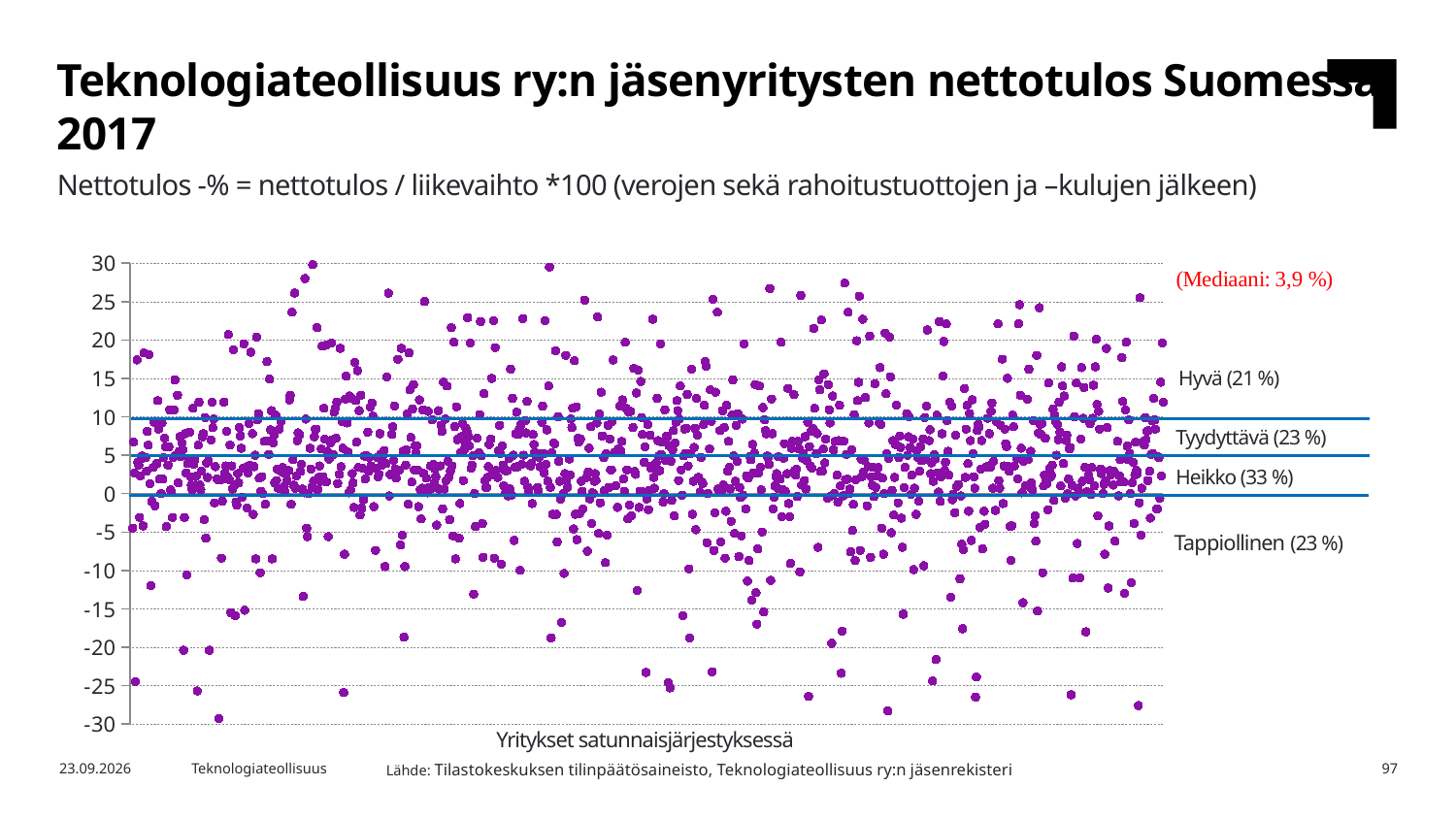
What share of companies falls into the 'Heikko' category? 33 % What is the difference in percentage points between the 'Heikko' share and the 'Hyvä' share? 12 Which category has the largest share of companies? Heikko What is the label of the x axis? Yritykset satunnaisjärjestyksessä What is the median net profit percentage stated on the chart? 3,9 % What share of companies falls into the 'Hyvä' category? 21 % Which has a larger share of companies, 'Heikko' or 'Tappiollinen'? Heikko What share of companies falls into the 'Tappiollinen' category? 23 % What kind of chart is shown on the slide? scatter plot How many category labels (Hyvä, Tyydyttävä, Heikko, Tappiollinen) are shown to the right of the chart? 4 Which category has the smallest share of companies? Hyvä What share of companies falls into the 'Tyydyttävä' category? 23 %